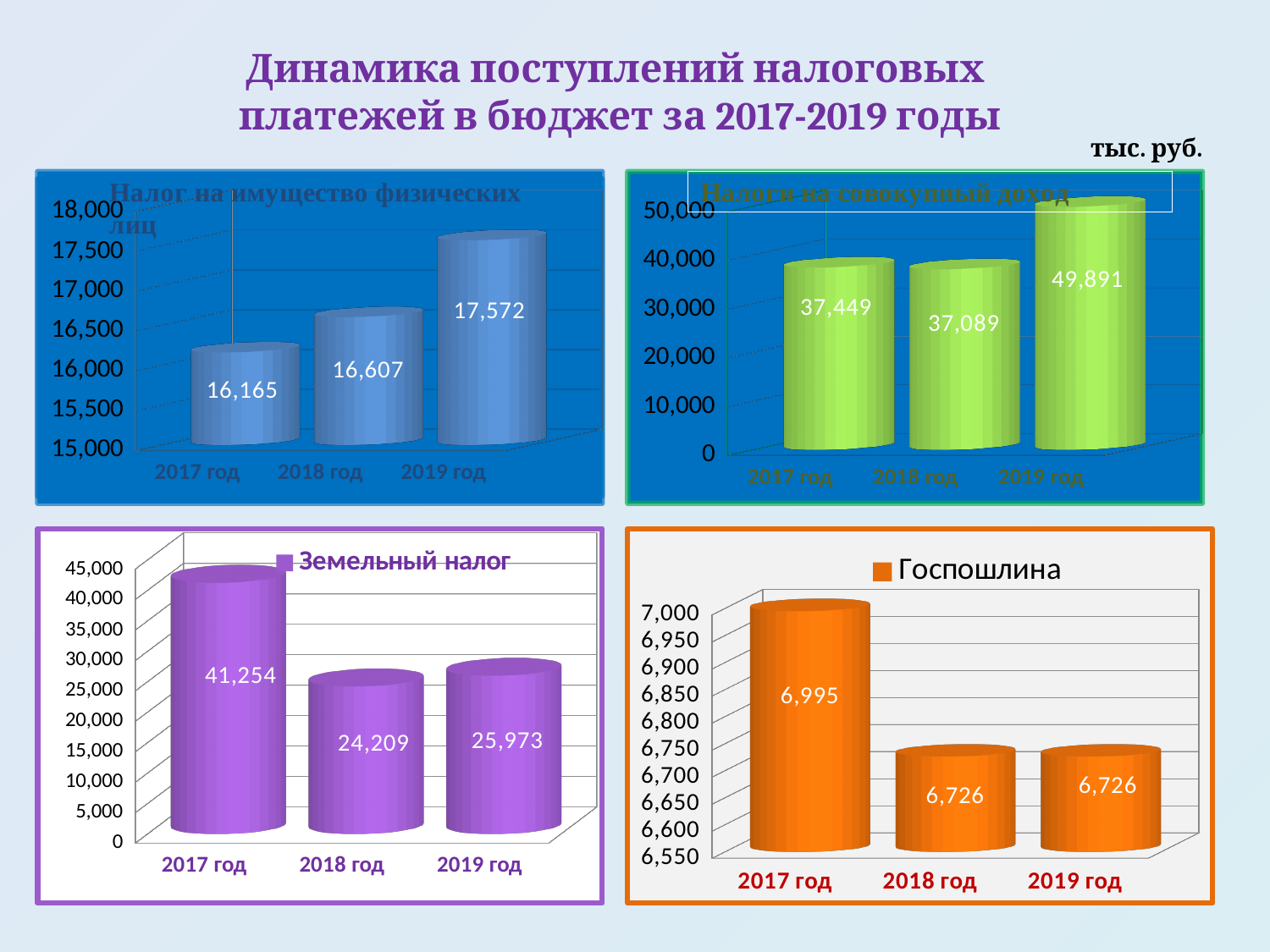
In the chart titled "Налог на имущество физических лиц", do the values rise or fall from 2017 год to 2019 год? rise What kind of chart is the chart titled "Земельный налог"? bar chart In the chart titled "Госпошлина", what is the value for 2019 год? 6,726 In the chart titled "Земельный налог", which is larger: the value for 2018 год or 2019 год? 2019 год In the chart titled "Земельный налог", what is the value for 2017 год? 41,254 In the chart titled "Земельный налог", which year has the lowest value? 2018 год In the chart titled "Госпошлина", what is the difference between the values for 2017 год and 2018 год? 269 In the chart titled "Налог на имущество физических лиц", what is the difference between the values for 2019 год and 2017 год? 1,407 In the chart titled "Налоги на совокупный доход", which year has the highest value? 2019 год In the chart titled "Налоги на совокупный доход", what is the value for 2018 год? 37,089 In the chart titled "Налог на имущество физических лиц", what is the value for 2019 год? 17,572 How many years are shown on the x axis of the chart titled "Госпошлина"? 3